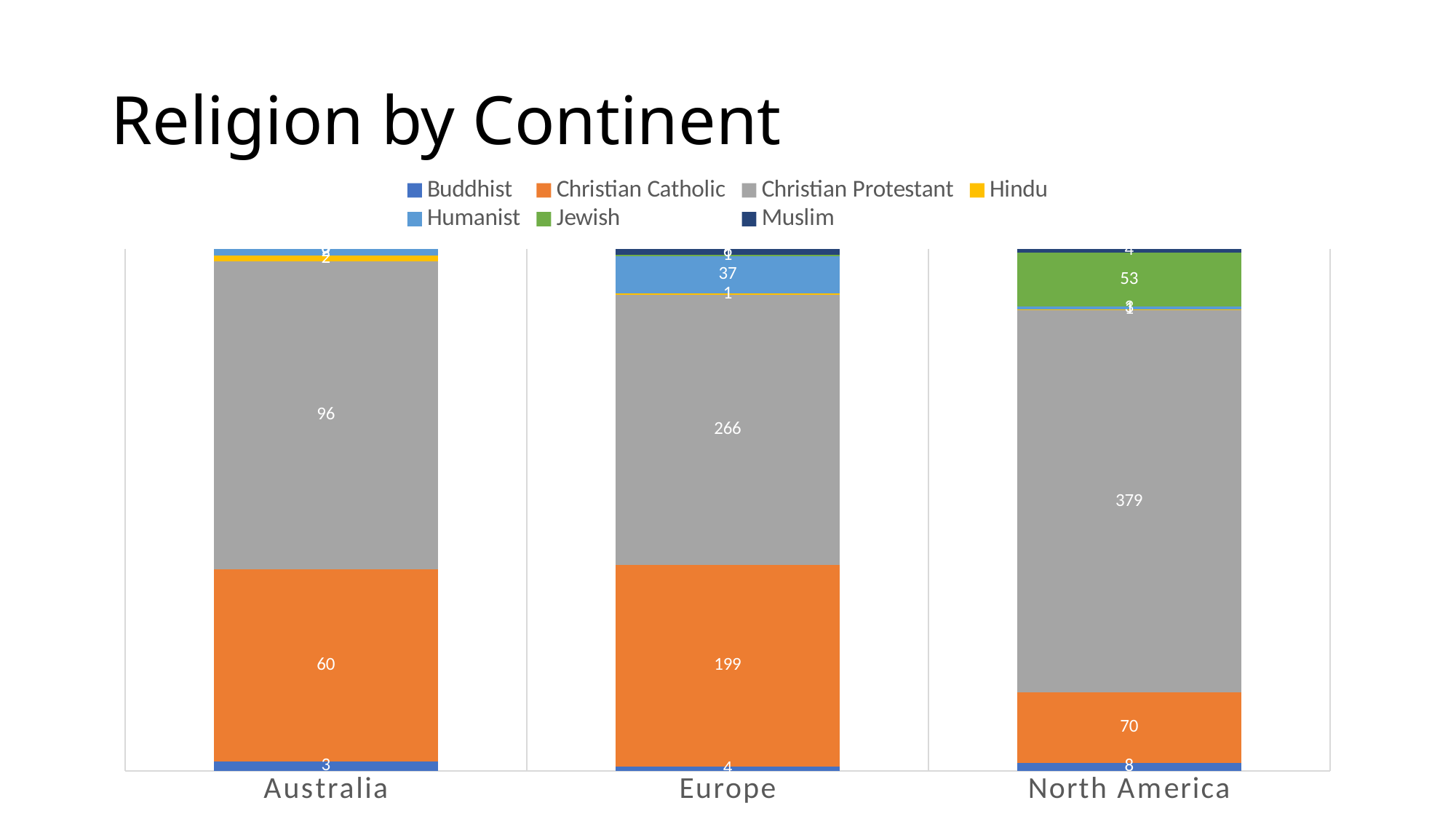
Which continent has the highest Christian Protestant value? North America What is the Christian Catholic value for Europe? 199 What is the title of the slide? Religion by Continent What kind of chart is shown on the slide? Stacked bar chart How many continents are shown on the x axis? 3 What is the Humanist value for Europe? 37 Which has the larger Christian Catholic value, Australia or North America? North America What is the difference between the Christian Protestant values for Europe and Australia? 170 What is the Christian Protestant value for North America? 379 Which continent has the lowest Buddhist value? Australia What is the Jewish value for North America? 53 How many series does the legend list? 7